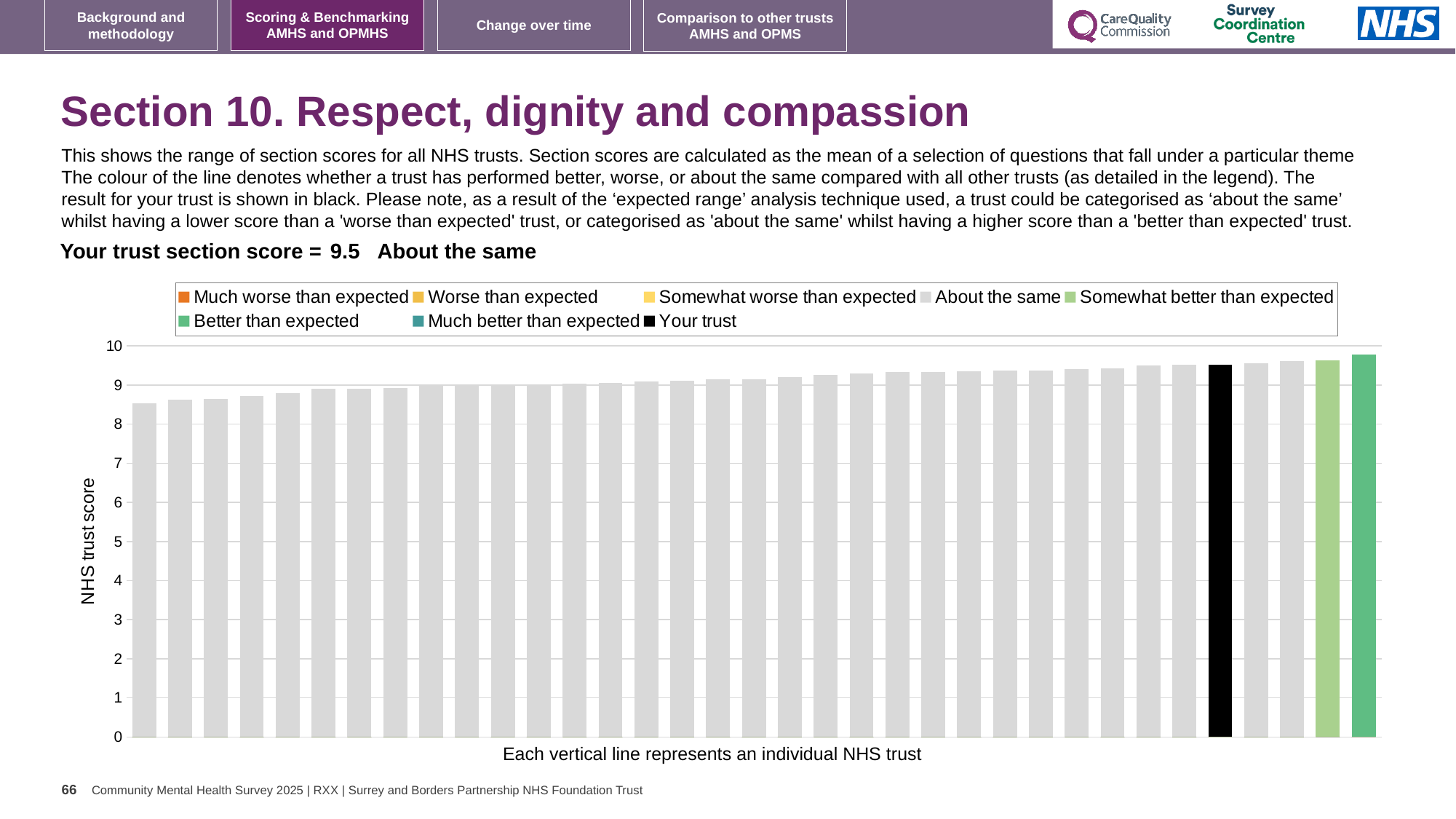
Is the value of the rightmost bar greater or less than 9? greater Do the bar values rise or fall from left to right across the chart? rise Is the value of the leftmost (lowest) bar greater or less than 9? less Which legend category does the tallest bar in the chart belong to? Better than expected Which legend entry does the black bar in the chart represent? Your trust What is the label on the vertical axis of the chart? NHS trust score Is the black 'Your trust' bar taller or shorter than the leftmost bar? taller Which performance category is your trust placed in for this section? About the same Is the value of the black 'Your trust' bar greater or less than 9? greater How many entries does the chart legend list? 8 What kind of chart is shown on the slide? bar chart What is the section score for your trust shown on the slide? 9.5